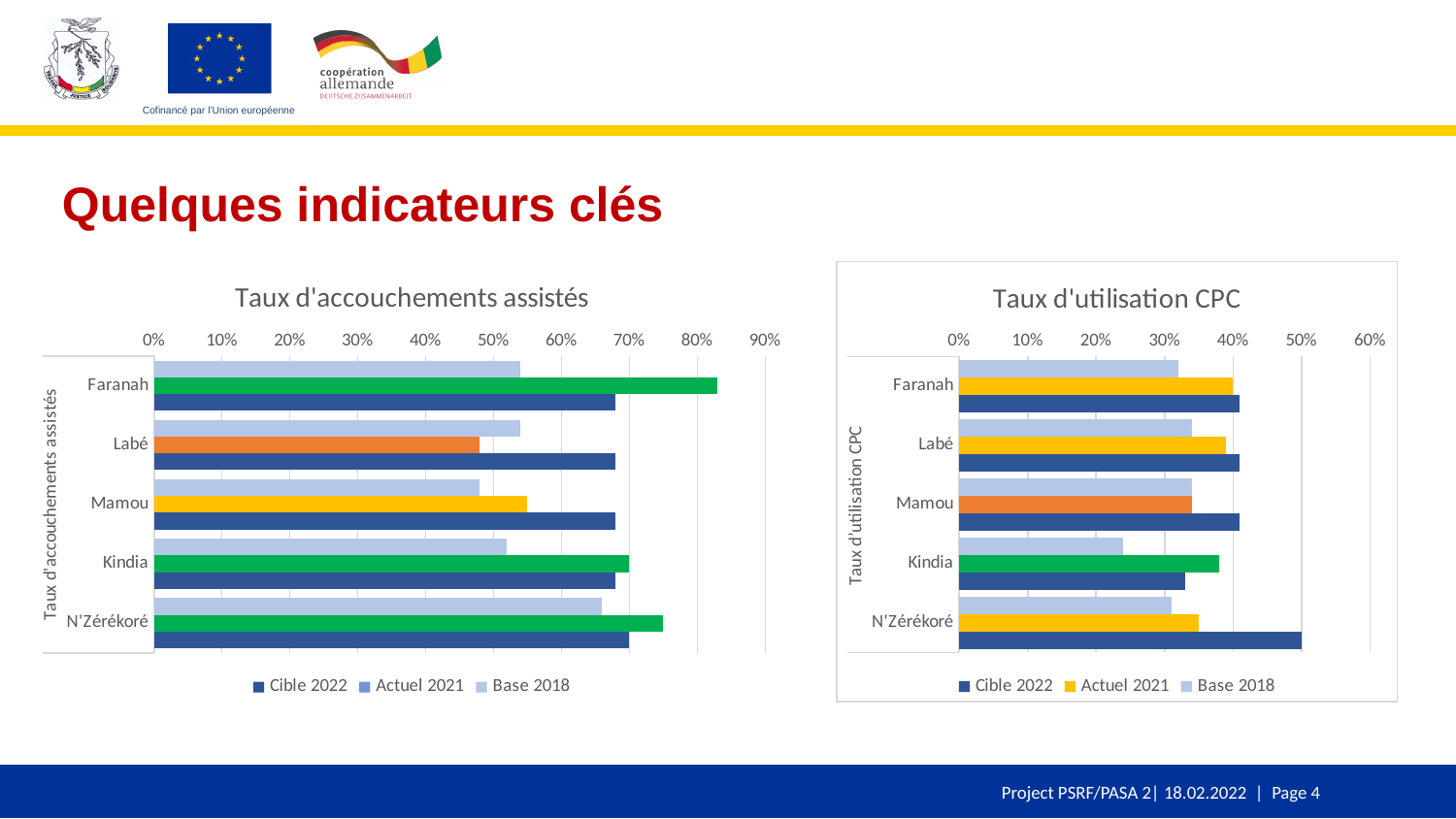
In the 'Taux d'accouchements assistés' chart, which is larger for Mamou: the Actuel 2021 value or the Cible 2022 value? Cible 2022 In the 'Taux d'accouchements assistés' chart, is the Actuel 2021 value for Labé greater or less than 50%? less In the 'Taux d'accouchements assistés' chart, is the Actuel 2021 value for Faranah greater or less than 80%? greater How many categories (regions) are shown on the 'Taux d'utilisation CPC' chart? 5 In the 'Taux d'utilisation CPC' chart, is the Cible 2022 value for N'Zérékoré greater or less than 40%? greater What is the title of the chart on the right side of the slide? Taux d'utilisation CPC In the 'Taux d'utilisation CPC' chart, which region has the highest Cible 2022 value? N'Zérékoré What kind of chart is the 'Taux d'accouchements assistés' chart? bar chart In the 'Taux d'utilisation CPC' chart, which region has the lowest Base 2018 value? Kindia How many series does the legend of the 'Taux d'accouchements assistés' chart list? 3 In the 'Taux d'accouchements assistés' chart, which region has the highest Actuel 2021 value? Faranah